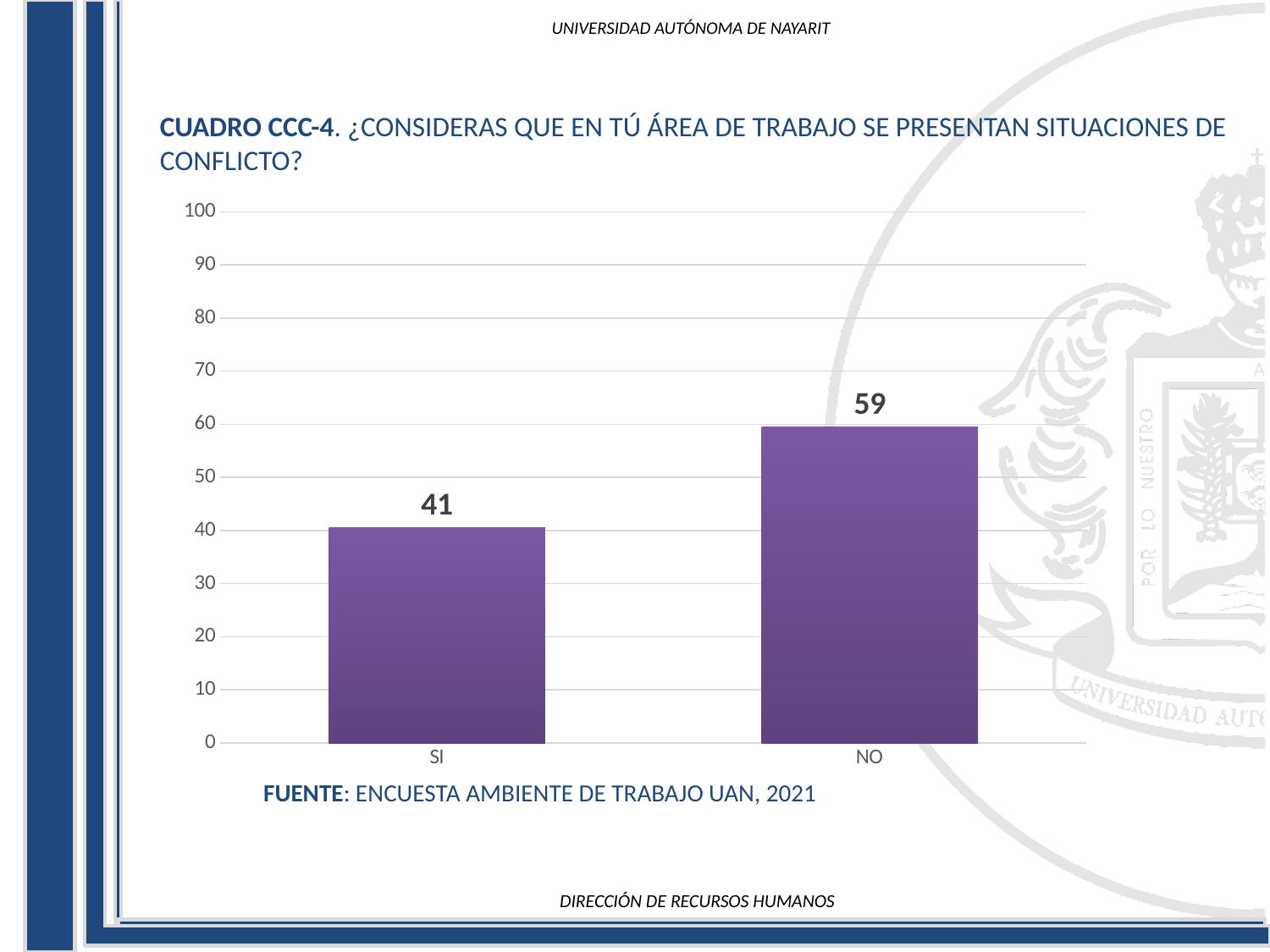
What is the value for SI? 41 Which is larger, the value for SI or the value for NO? NO What is the value for NO? 59 Is the value for SI greater or less than 50? less Which category has the lowest value? SI Is the value for NO greater or less than 50? greater What is the maximum value shown on the y axis? 100 Which category has the highest value? NO What kind of chart is shown on the slide? bar chart How many categories are shown on the x axis? 2 What is the total of the two values shown in the chart? 100 What is the difference between the values for NO and SI? 18